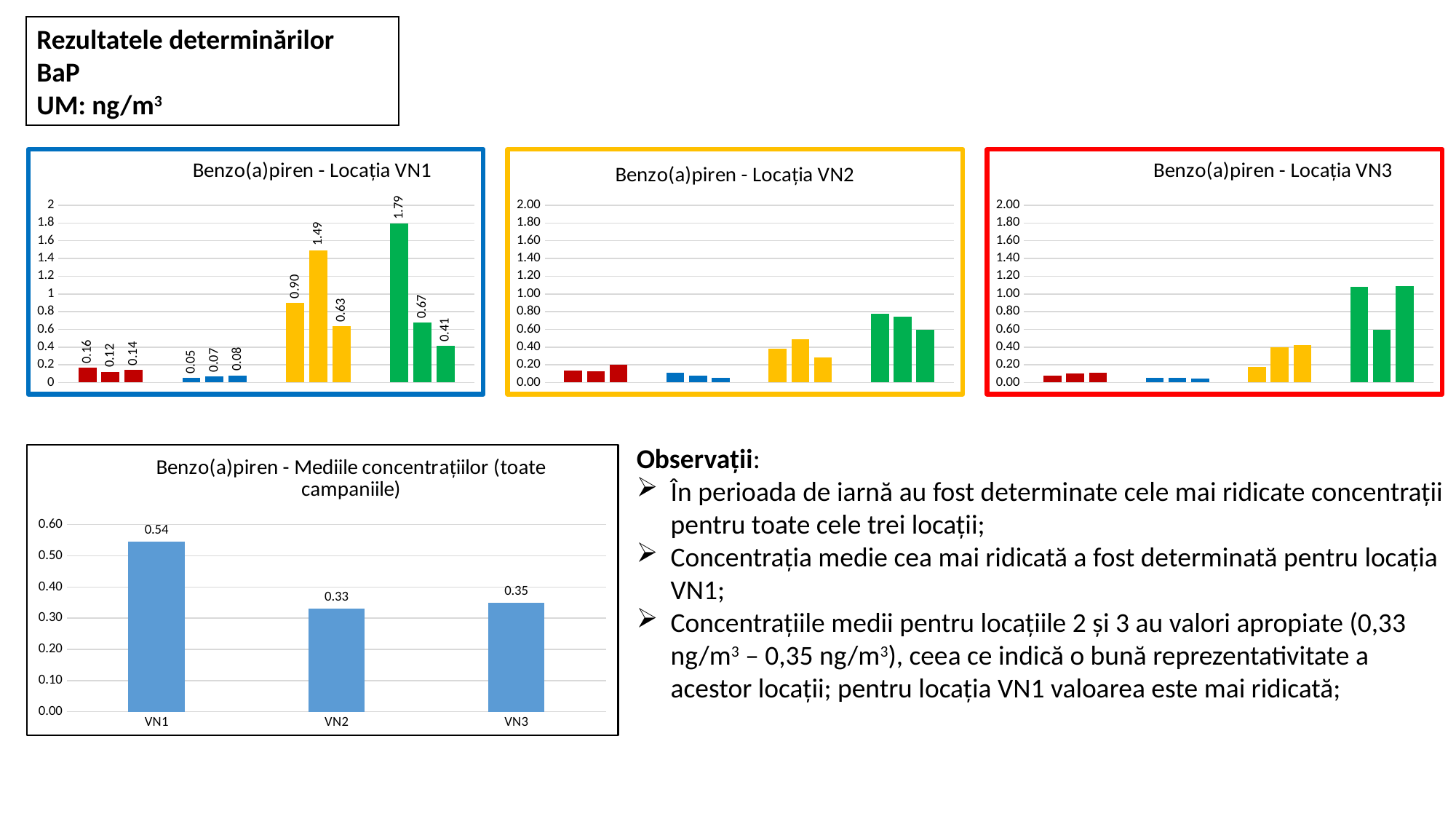
In the chart titled 'Benzo(a)piren - Locația VN1', what is the lowest value labelled on any bar? 0.05 In the chart titled 'Benzo(a)piren - Mediile concentrațiilor (toate campaniile)', what is the value for VN2? 0.33 In the chart titled 'Benzo(a)piren - Mediile concentrațiilor (toate campaniile)', what is the value for VN1? 0.54 In the chart titled 'Benzo(a)piren - Mediile concentrațiilor (toate campaniile)', which location has the highest value? VN1 In the chart titled 'Benzo(a)piren - Locația VN1', how many bars are plotted? 12 In the chart titled 'Benzo(a)piren - Mediile concentrațiilor (toate campaniile)', how many locations are shown? 3 In the chart titled 'Benzo(a)piren - Locația VN1', what is the highest value labelled on any bar? 1.79 In the chart titled 'Benzo(a)piren - Mediile concentrațiilor (toate campaniile)', what is the difference between the values for VN1 and VN3? 0.19 In the chart titled 'Benzo(a)piren - Locația VN3', is the value of the tallest bar greater or less than 1.00? greater In the chart titled 'Benzo(a)piren - Mediile concentrațiilor (toate campaniile)', which location has the lowest value? VN2 In the chart titled 'Benzo(a)piren - Locația VN2', is the value of the tallest bar greater or less than 0.60? greater What kind of chart is 'Benzo(a)piren - Mediile concentrațiilor (toate campaniile)'? Bar chart